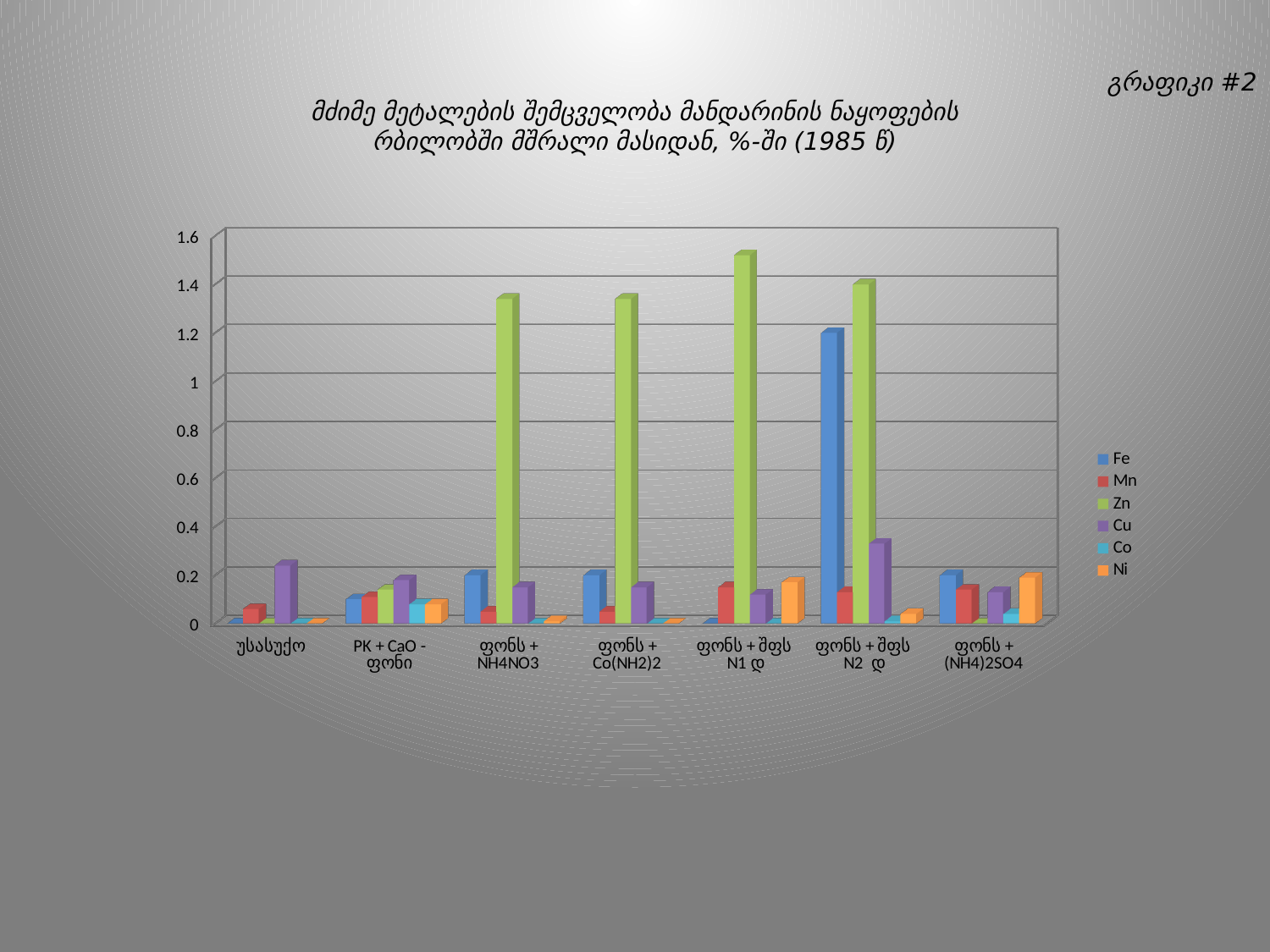
Which series has the highest value in the category ფონი + შფს N2 დ? Zn In the category ფონი + შფს N2 დ, which is larger, the Fe value or the Zn value? Zn Which series has the highest value in the category უსასუქო? Cu Is the Zn value for ფონი + შფს N1 დ greater or less than 1.4? greater What kind of chart is shown on the slide? bar chart Is the Fe value for ფონი + შფს N2 დ greater or less than 1? greater Is the Zn value for უსასუქო greater or less than 0.2? less Which colour represents Zn in the legend? green How many series does the legend list? 6 Which category has the highest Zn value? ფონი + შფს N1 დ How many categories are shown along the x axis? 7